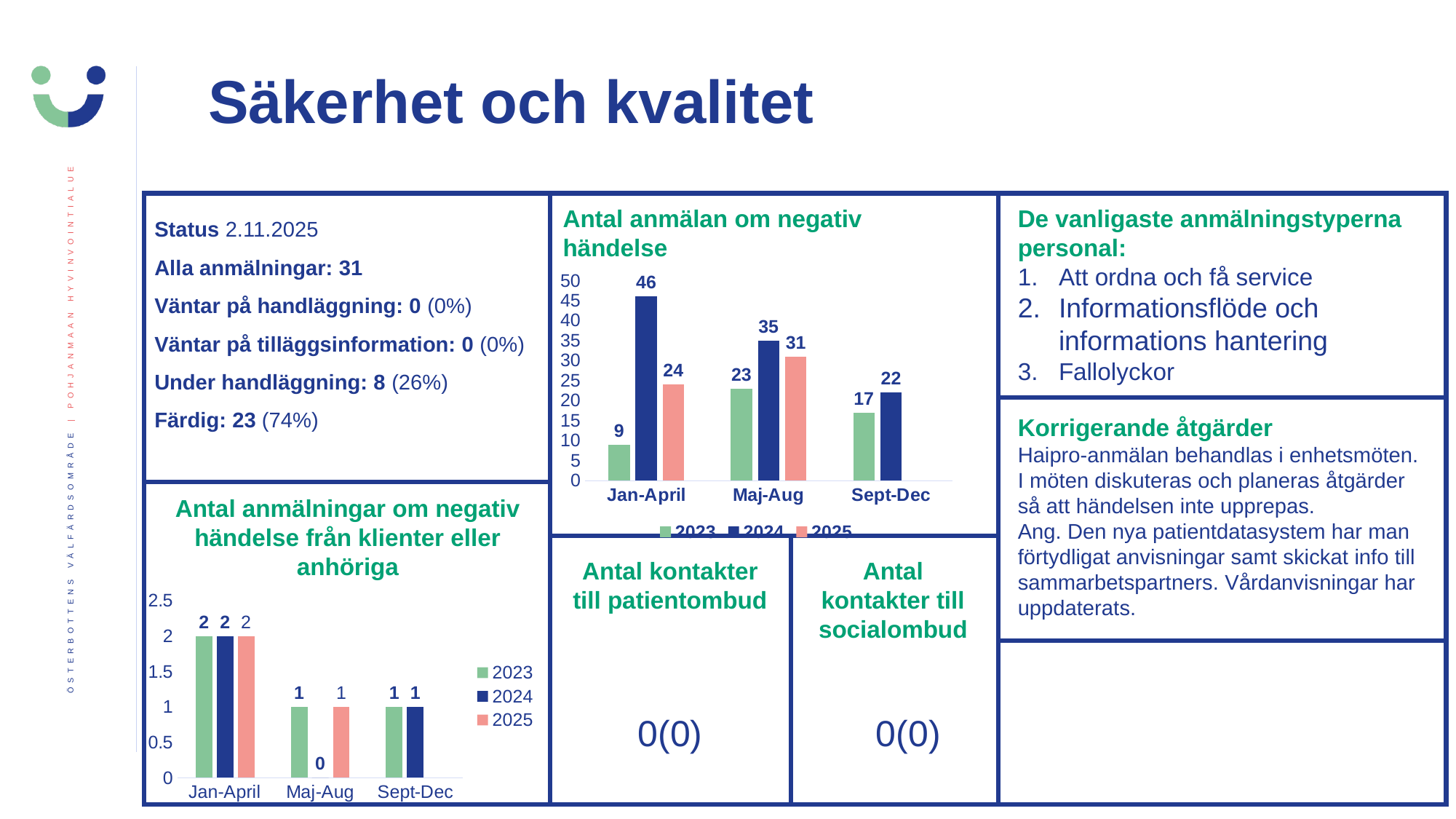
In the chart 'Antal anmälan om negativ händelse', which is larger in Maj-Aug: the 2024 value or the 2025 value? 2024 In the chart 'Antal anmälningar om negativ händelse från klienter eller anhöriga', which colour represents 2025 in the legend? salmon/pink In the chart 'Antal anmälan om negativ händelse', which period has the lowest value for 2024? Sept-Dec In the chart 'Antal anmälan om negativ händelse', what is the value for 2024 in Jan-April? 46 In the chart 'Antal anmälningar om negativ händelse från klienter eller anhöriga', what is the value for 2023 in Jan-April? 2 In the chart 'Antal anmälan om negativ händelse', what is the difference between the 2024 and 2023 values in Jan-April? 37 In the chart 'Antal anmälan om negativ händelse', what is the value for 2025 in Maj-Aug? 31 In the chart 'Antal anmälan om negativ händelse', how many periods are shown on the x axis? 3 In the chart 'Antal anmälan om negativ händelse', which period has the highest value for 2023? Maj-Aug In the chart 'Antal anmälningar om negativ händelse från klienter eller anhöriga', what is the value for 2024 in Maj-Aug? 0 What kind of chart is 'Antal anmälningar om negativ händelse från klienter eller anhöriga'? bar chart In the chart 'Antal anmälan om negativ händelse', how many series does the legend list? 3